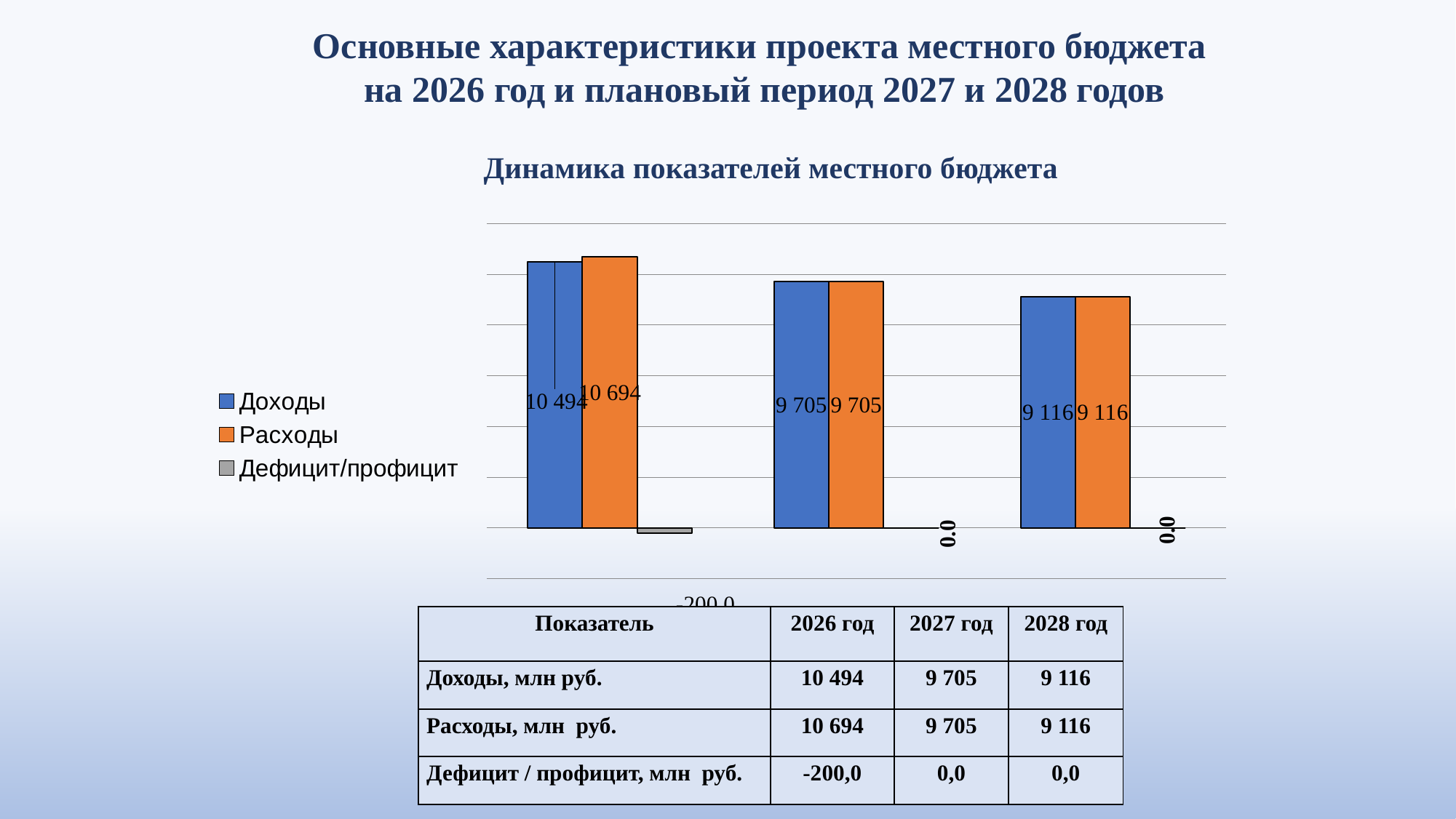
Do the Доходы values rise or fall from the leftmost group to the rightmost group? fall In which group of bars is the Доходы value highest? the first (leftmost) group, 10 494 In which group of bars is the Расходы value lowest? the third (rightmost) group, 9 116 What is the value of the Доходы bar in the first (leftmost) group of the chart? 10 494 How many series does the legend of the chart list? 3 What is the value of the Дефицит/профицит series in the third (rightmost) group of the chart? 0,0 How many groups of bars are plotted in the chart? 3 What is the value of the Расходы bar in the third (rightmost) group of the chart? 9 116 What is the value of the Расходы bar in the first (leftmost) group of the chart? 10 694 What is the difference between the Расходы and Доходы values in the first (leftmost) group of the chart? 200 What is the value of the Доходы bar in the second (middle) group of the chart? 9 705 What kind of chart is shown under the title "Динамика показателей местного бюджета"? bar chart